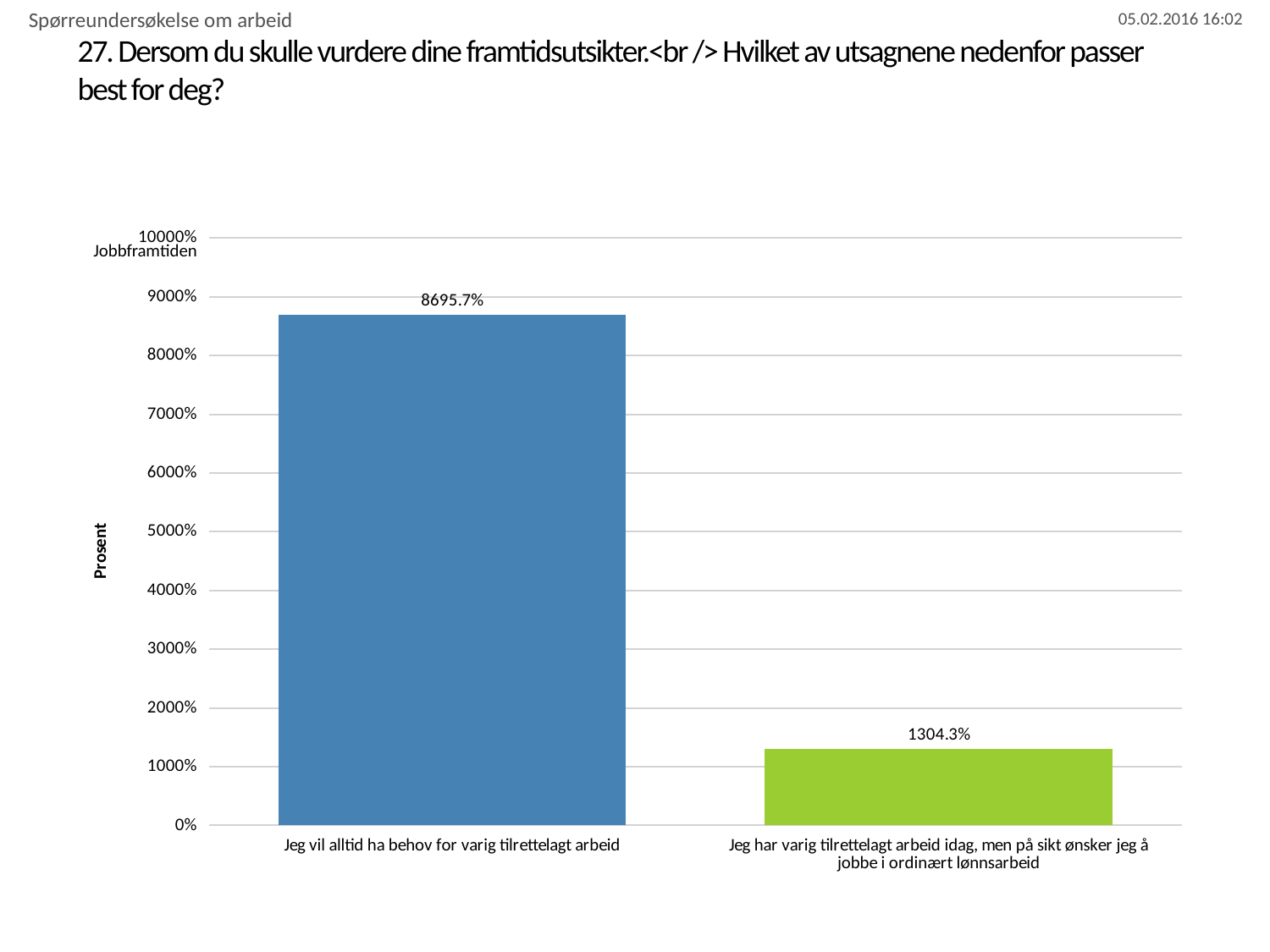
What is the value for "Jeg vil alltid ha behov for varig tilrettelagt arbeid"? 8695.7% What is the value for "Jeg har varig tilrettelagt arbeid idag, men på sikt ønsker jeg å jobbe i ordinært lønnsarbeid"? 1304.3% How many categories are shown in the chart? 2 What kind of chart is shown on the slide? Bar chart Which category has the lowest value? Jeg har varig tilrettelagt arbeid idag, men på sikt ønsker jeg å jobbe i ordinært lønnsarbeid Which category has the highest value? Jeg vil alltid ha behov for varig tilrettelagt arbeid What is the difference between the value for "Jeg vil alltid ha behov for varig tilrettelagt arbeid" and the value for "Jeg har varig tilrettelagt arbeid idag, men på sikt ønsker jeg å jobbe i ordinært lønnsarbeid"? 7391.4% Which is larger: the value for "Jeg vil alltid ha behov for varig tilrettelagt arbeid" or the value for "Jeg har varig tilrettelagt arbeid idag, men på sikt ønsker jeg å jobbe i ordinært lønnsarbeid"? Jeg vil alltid ha behov for varig tilrettelagt arbeid Is the value for "Jeg vil alltid ha behov for varig tilrettelagt arbeid" greater or less than 8000%? greater Is the value for "Jeg har varig tilrettelagt arbeid idag, men på sikt ønsker jeg å jobbe i ordinært lønnsarbeid" greater or less than 2000%? less What is the title of the chart? Jobbframtiden What is the label of the vertical axis? Prosent